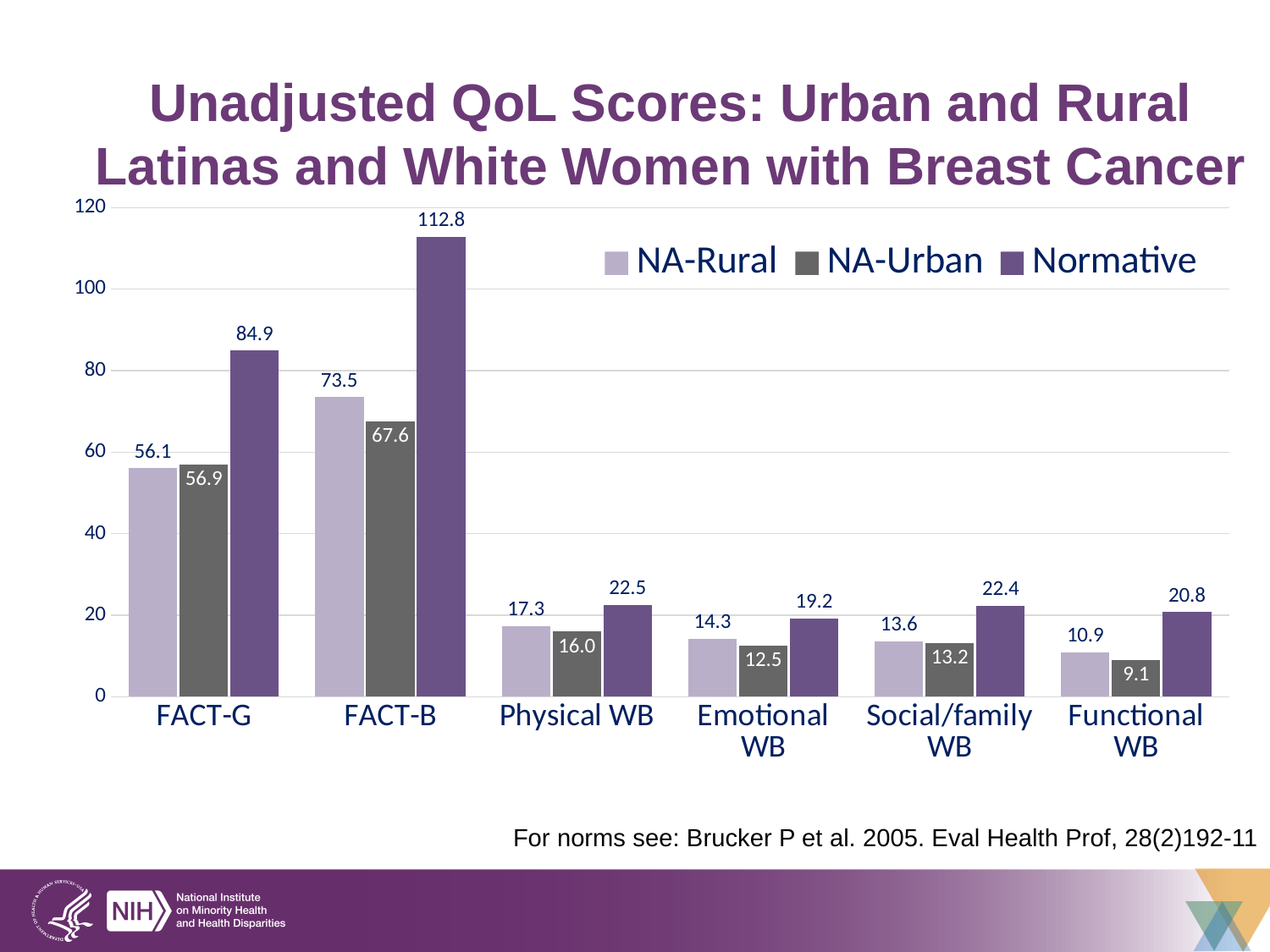
Which category has the lowest NA-Urban value? Functional WB Which category has the highest Normative value? FACT-B What is the difference between the Normative and NA-Rural values for FACT-G? 28.8 How many series does the legend list? 3 Which series is shown in the darkest purple colour? Normative What kind of chart is shown on the slide? bar chart What is the Normative value for FACT-B? 112.8 Which is larger for Emotional WB: the NA-Rural value or the NA-Urban value? NA-Rural Is the NA-Urban value for FACT-B greater or less than 60? greater What is the NA-Urban value for Physical WB? 16.0 What is the NA-Rural value for Functional WB? 10.9 How many categories are shown on the x axis? 6